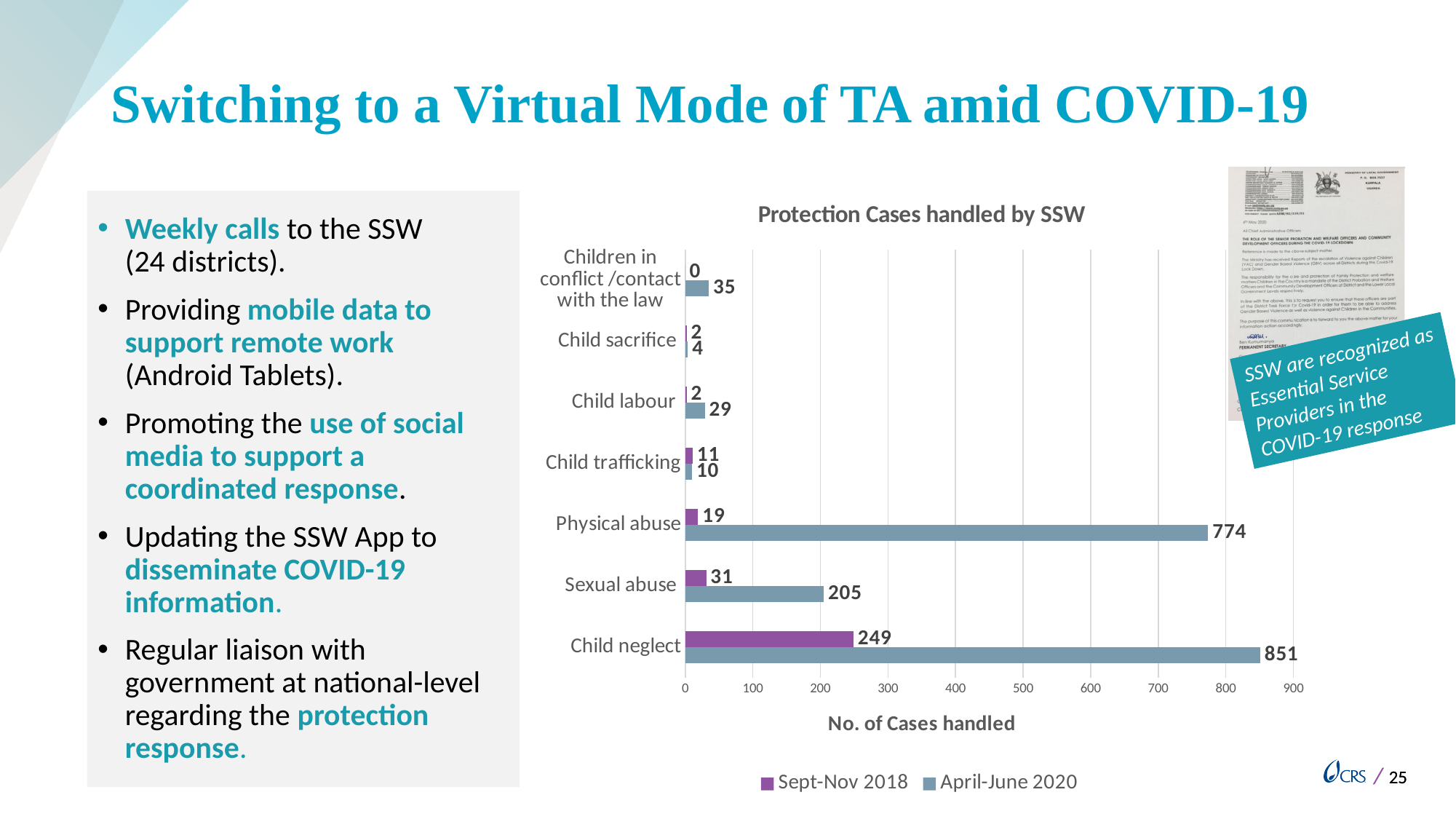
What is the title of the chart? Protection Cases handled by SSW What kind of chart is shown on the slide? Bar chart Which category has the highest value in the April-June 2020 series? Child neglect What is the value for Child neglect in the April-June 2020 series? 851 How many series does the legend list? 2 Which category has the lowest value in the Sept-Nov 2018 series? Children in conflict /contact with the law Is the April-June 2020 value for Physical abuse greater or less than 700? greater What is the value for Physical abuse in the Sept-Nov 2018 series? 19 What is the value for Sexual abuse in the April-June 2020 series? 205 How many categories are shown on the chart? 7 For Child trafficking, which series has the larger value, Sept-Nov 2018 or April-June 2020? Sept-Nov 2018 What is the difference between the April-June 2020 and Sept-Nov 2018 values for Child neglect? 602